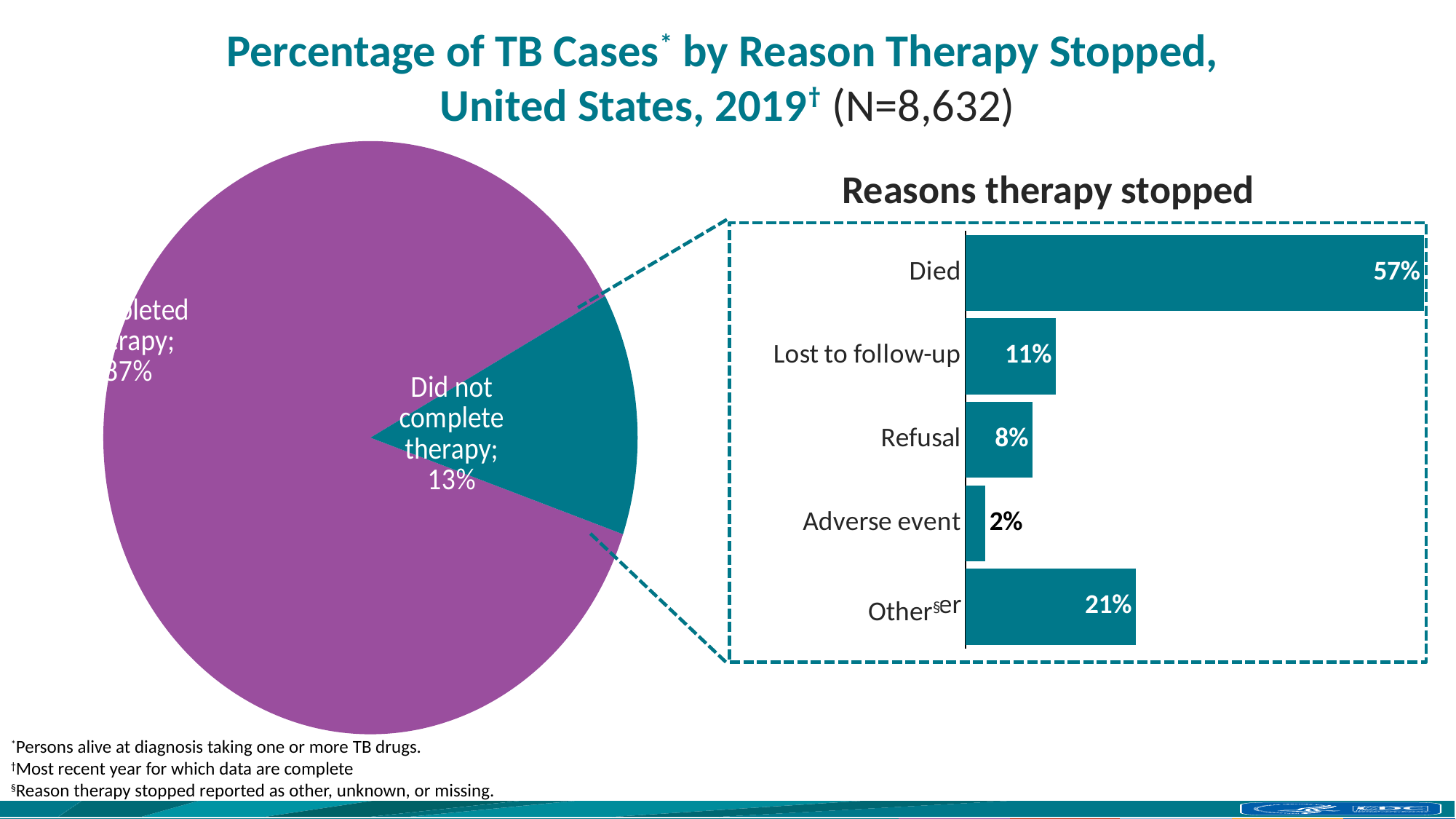
What kind of chart is shown on the left side of the slide? Pie chart In the 'Reasons therapy stopped' bar chart, what is the difference in percentage points between Died and Other? 36 percentage points In the pie chart on the left, what share of cases did not complete therapy? 13% In the 'Reasons therapy stopped' bar chart, what percentage is shown for Adverse event? 2% How many reasons are listed in the 'Reasons therapy stopped' bar chart? 5 In the 'Reasons therapy stopped' bar chart, which reason has the highest percentage? Died In the 'Reasons therapy stopped' bar chart, which reason has the lowest percentage? Adverse event What kind of chart is the 'Reasons therapy stopped' chart on the right? Bar chart In the 'Reasons therapy stopped' bar chart, which is larger: Lost to follow-up or Refusal? Lost to follow-up In the 'Reasons therapy stopped' bar chart, what percentage is shown for Died? 57% In the 'Reasons therapy stopped' bar chart, what percentage is shown for Refusal? 8% In the 'Reasons therapy stopped' bar chart, what percentage is shown for Lost to follow-up? 11%